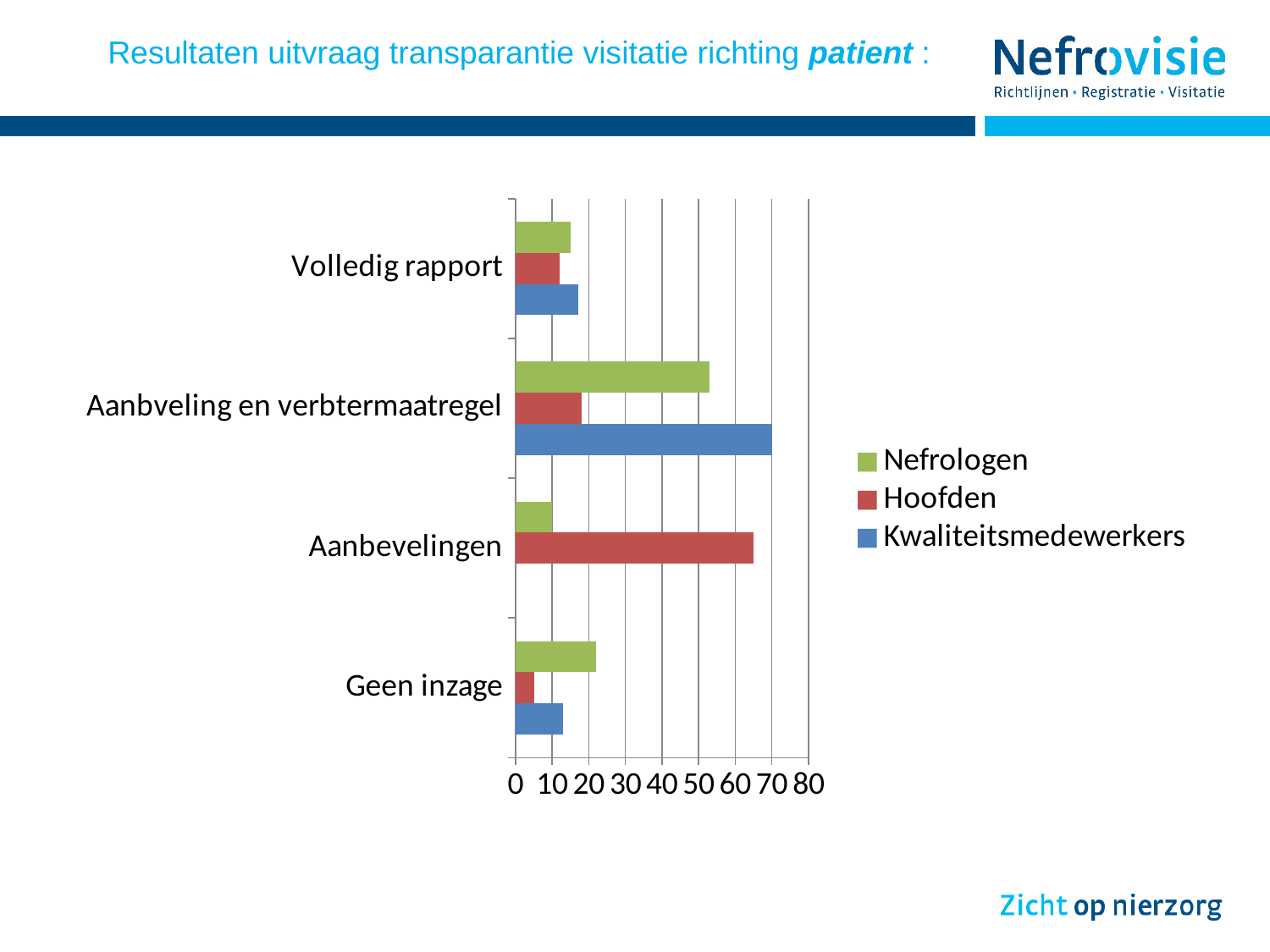
For Aanbevelingen, which is larger: Hoofden or Nefrologen? Hoofden Which series has the highest value for Aanbevelingen? Hoofden How many series does the legend list? 3 Is the value for Hoofden in Geen inzage greater or less than 10? less What kind of chart is shown on the slide? bar chart Which series has the lowest value for Geen inzage? Hoofden For Geen inzage, which is larger: Nefrologen or Kwaliteitsmedewerkers? Nefrologen How many categories are shown on the chart? 4 Is the value for Nefrologen in Aanbveling en verbtermaatregel greater or less than 40? greater What are the three series listed in the legend? Nefrologen, Hoofden, Kwaliteitsmedewerkers Which category has the highest value for Kwaliteitsmedewerkers? Aanbveling en verbtermaatregel Is the value for Kwaliteitsmedewerkers in Aanbveling en verbtermaatregel greater or less than 60? greater